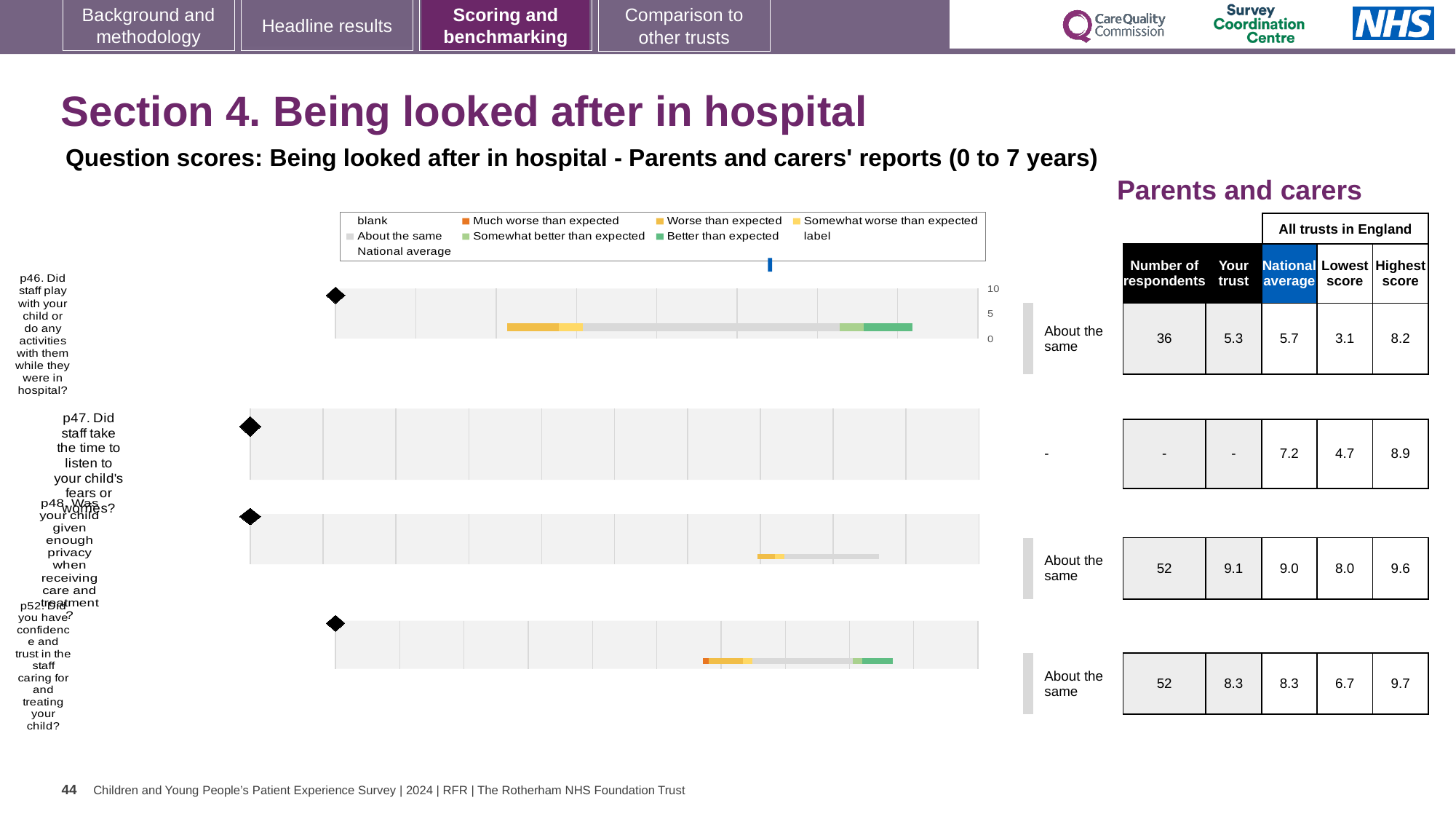
What is the highest score across all trusts in England for p52 (Did you have confidence and trust in the staff caring for and treating your child?)? 9.7 Which question has the lowest national average score? p46 How many questions (categories) are plotted in the chart? 4 Which colour in the legend represents 'Better than expected'? Green What is the 'Your trust' score for p46 (Did staff play with your child or do any activities with them while they were in hospital?)? 5.3 For p46, which is larger: the 'Your trust' score or the national average? National average Which question has the highest 'Your trust' score? p48 What benchmark category is shown for p52? About the same What is the national average score for p47 (Did staff take the time to listen to your child's fears or worries?)? 7.2 What is the difference between the highest score (8.2) and the lowest score (3.1) for p46? 5.1 What kind of chart is shown on the slide? bar chart How many respondents answered p48 (Was your child given enough privacy when receiving care and treatment?)? 52